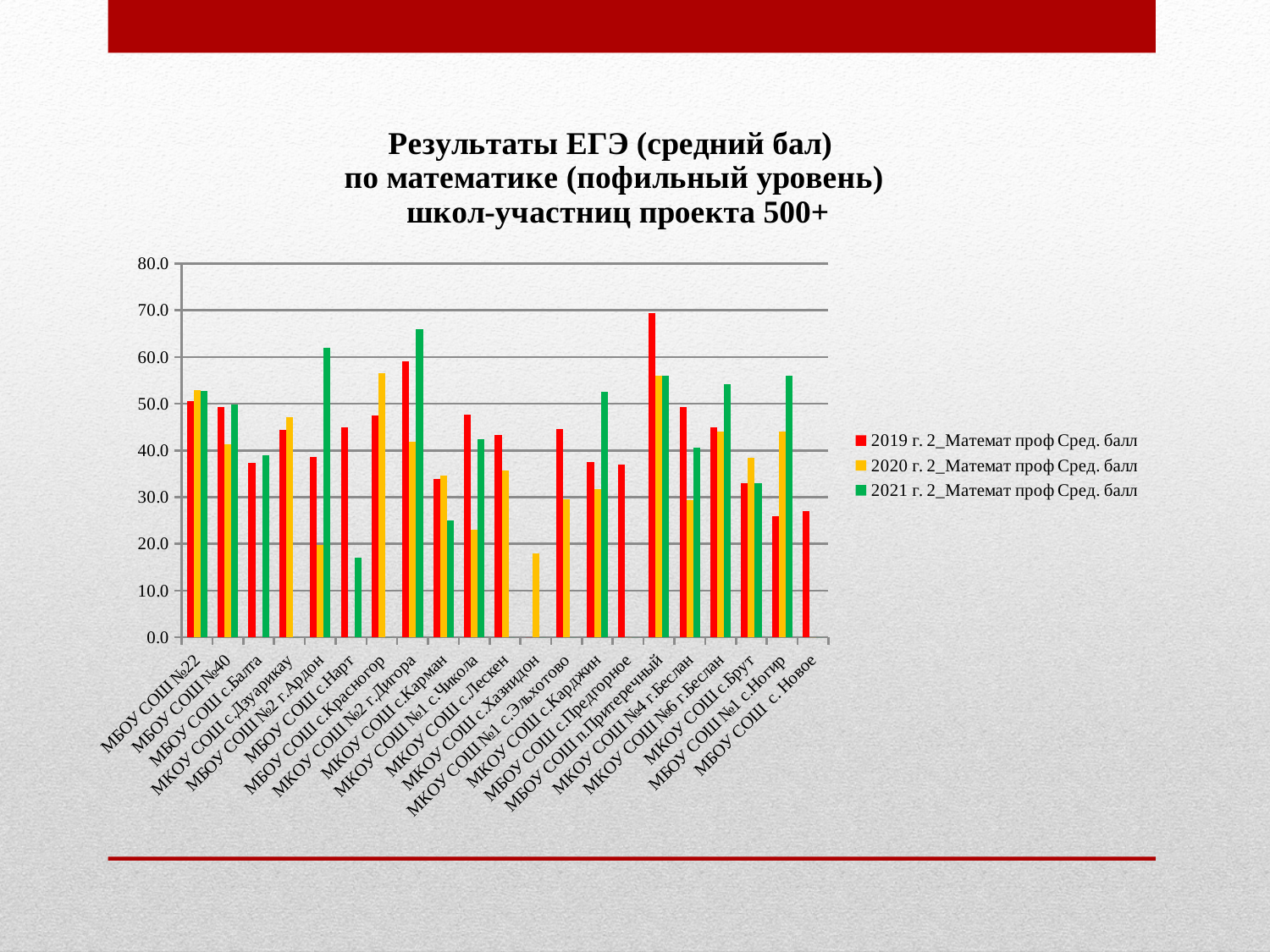
How many series does the legend list? 3 How many schools (categories) are shown on the x axis? 21 Which school has the highest value for the 2021 series? МКОУ СОШ №2 г.Дигора For МБОУ СОШ №1 с.Ногир, which is larger: the 2019 value or the 2021 value? 2021 What colour represents the 2020 series in the legend? yellow Is the 2021 value for МБОУ СОШ №2 г.Ардон greater or less than 60? greater What kind of chart is shown on the slide? bar chart Which school has the highest value for the 2019 series? МБОУ СОШ п.Притеречный Is the 2020 value for МКОУ СОШ №1 с.Хазнидон greater or less than 20? less Is the 2021 value for МБОУ СОШ с.Нарт greater or less than 20? less